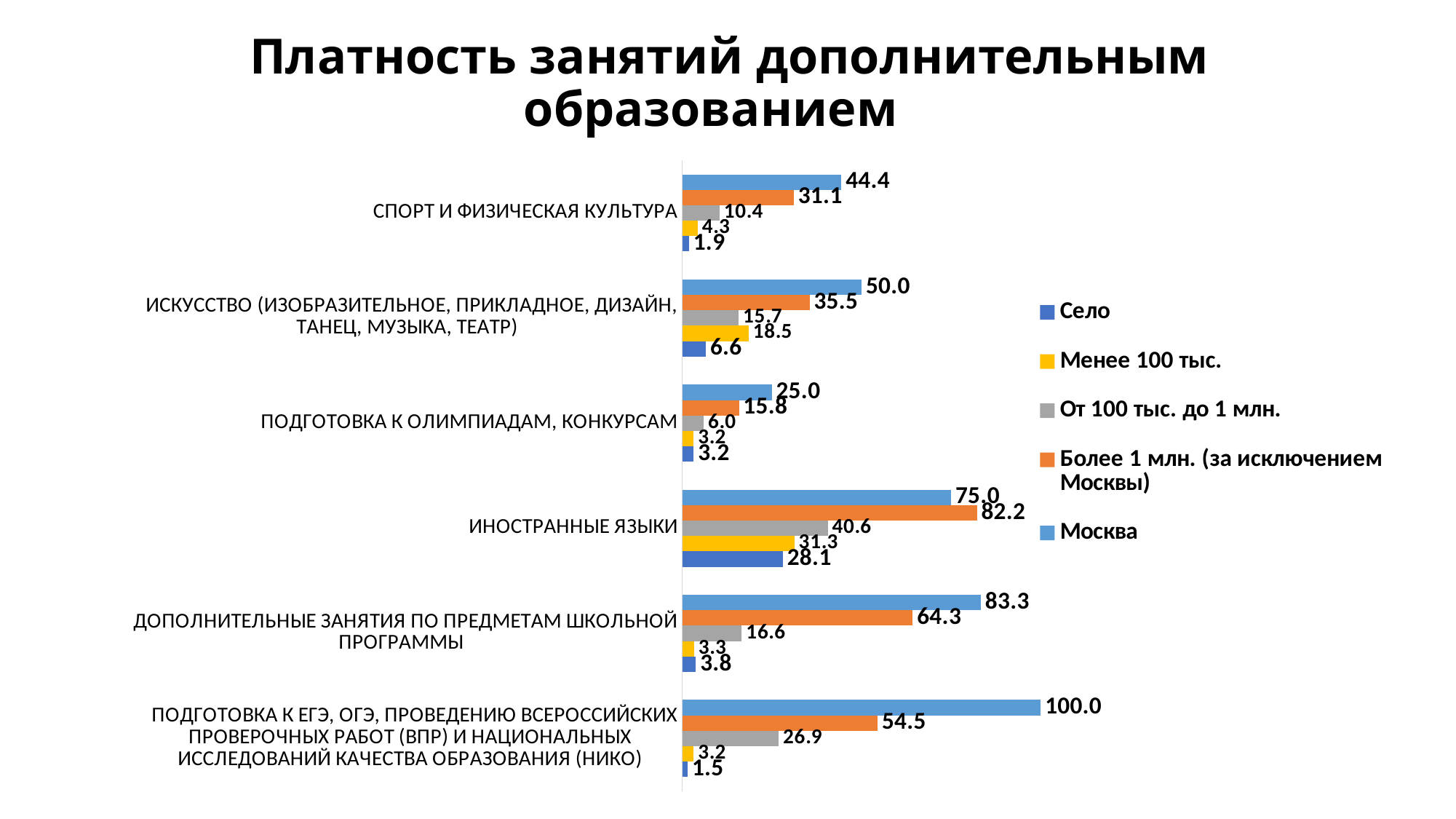
What is the value for 'Менее 100 тыс.' in the category 'Искусство (изобразительное, прикладное, дизайн, танец, музыка, театр)'? 18.5 What is the value for Москва in the category 'Подготовка к ЕГЭ, ОГЭ, проведению всероссийских проверочных работ (ВПР) и национальных исследований качества образования (НИКО)'? 100.0 Which legend entry is shown in orange? Более 1 млн. (за исключением Москвы) Which category has the lowest value for the Село series? Подготовка к ЕГЭ, ОГЭ, проведению всероссийских проверочных работ (ВПР) и национальных исследований качества образования (НИКО) What is the value for 'От 100 тыс. до 1 млн.' in the category 'Спорт и физическая культура'? 10.4 Which category has the highest value for the Москва series? Подготовка к ЕГЭ, ОГЭ, проведению всероссийских проверочных работ (ВПР) и национальных исследований качества образования (НИКО) What type of chart is shown on the slide? bar chart In the category 'Иностранные языки', which is larger: the value for Москва or the value for 'Более 1 млн. (за исключением Москвы)'? Более 1 млн. (за исключением Москвы) What is the value for Село in the category 'Иностранные языки'? 28.1 What is the difference between the Москва and 'Более 1 млн. (за исключением Москвы)' values in the category 'Дополнительные занятия по предметам школьной программы'? 19.0 How many categories are shown on the chart? 6 How many series does the legend list? 5